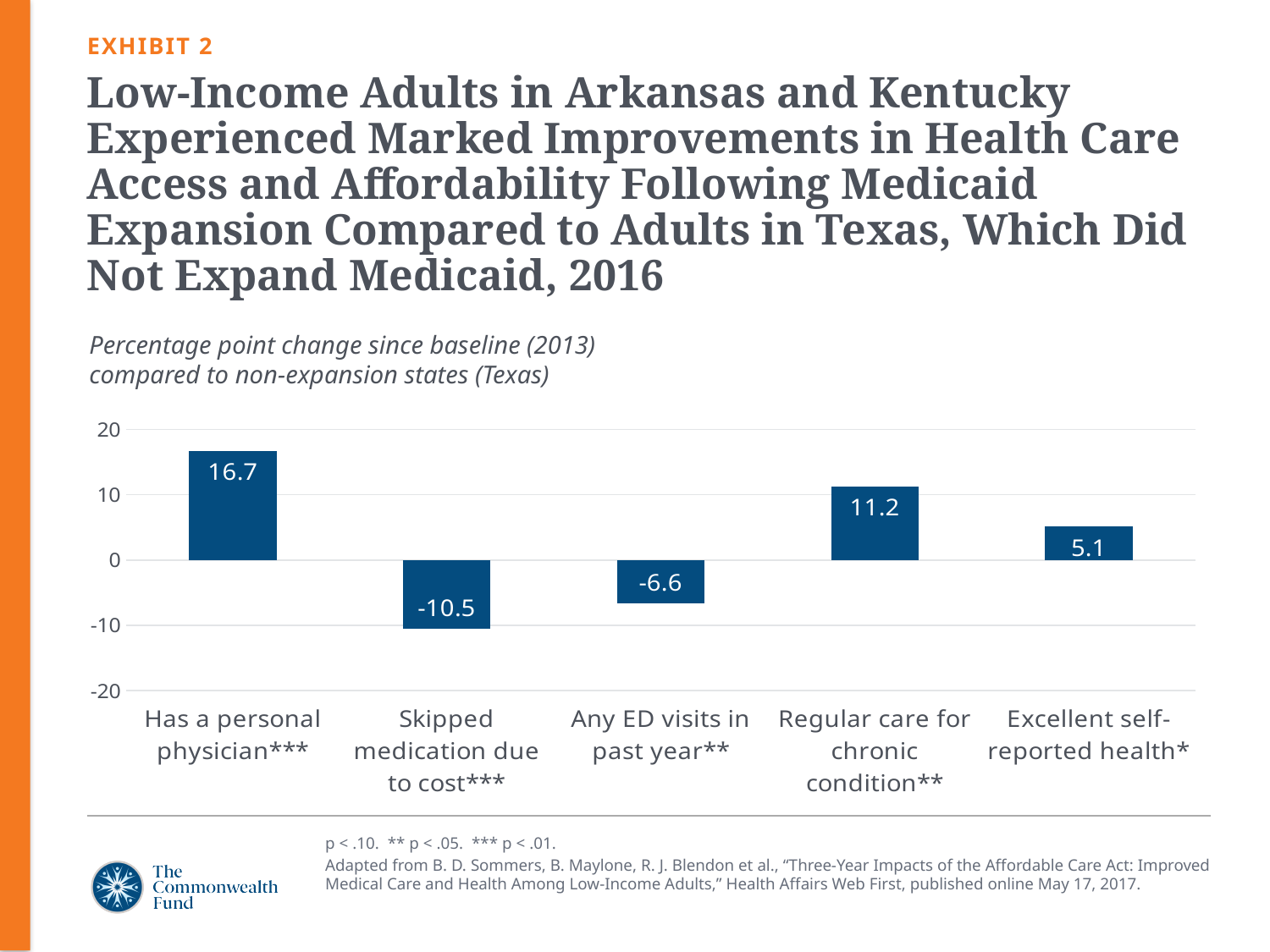
What is the difference between the values for "Has a personal physician" and "Regular care for chronic condition"? 5.5 What is the value shown for "Skipped medication due to cost"? -10.5 Which category has the highest value? Has a personal physician How many categories are shown on the chart? 5 Which category has the lowest value? Skipped medication due to cost Which is larger, the value for "Regular care for chronic condition" or "Excellent self-reported health"? Regular care for chronic condition What is the value shown for "Excellent self-reported health"? 5.1 What is the value shown for "Any ED visits in past year"? -6.6 What is the percentage point change for "Has a personal physician"? 16.7 What is the value shown for "Regular care for chronic condition"? 11.2 How many categories on the chart have negative values? 2 What kind of chart is shown on the slide? Bar chart